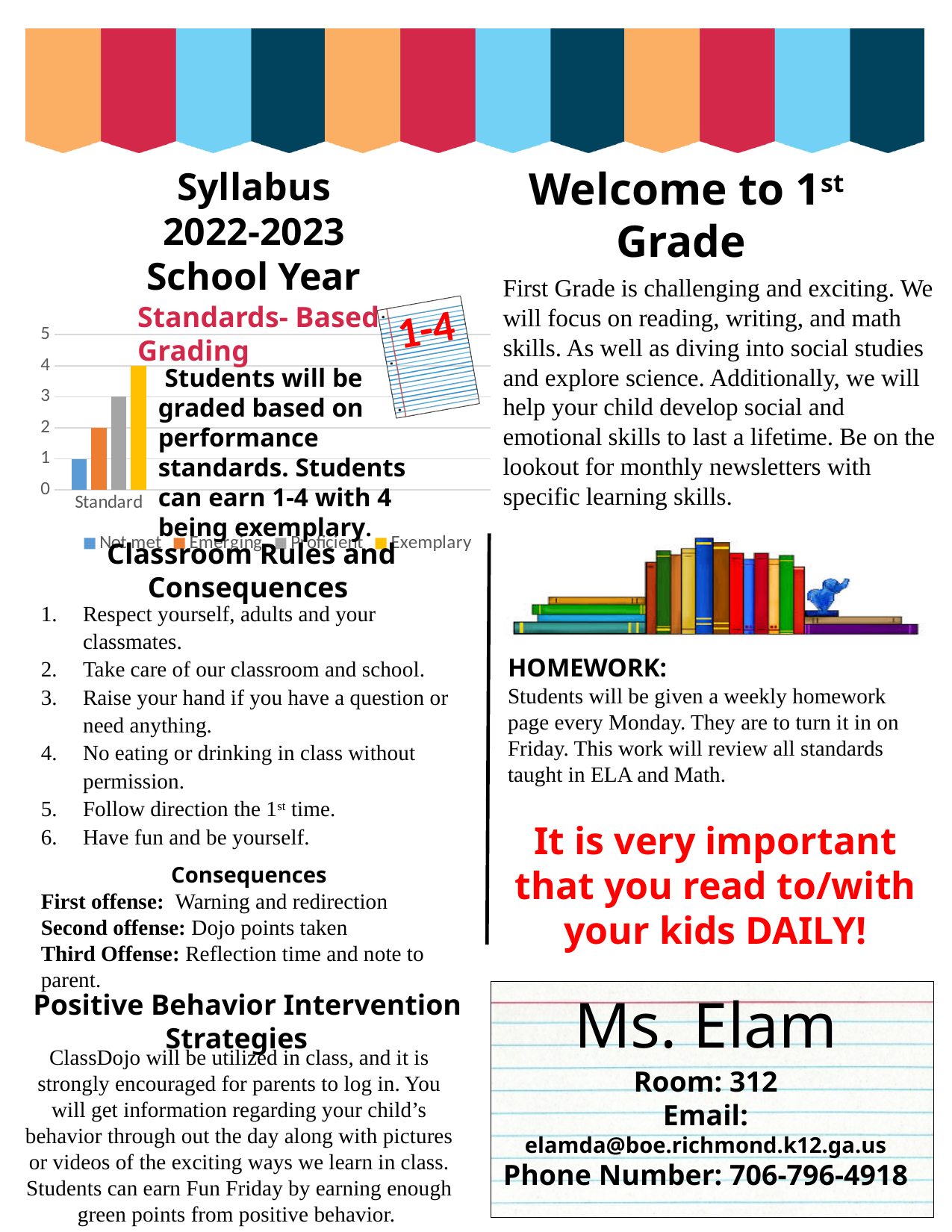
How many categories are shown on the x axis of the chart? 1 How many series does the chart legend list? 4 Which series has the highest bar in the chart? Exemplary What is the value of the Not met bar in the chart? 1 What kind of chart is shown on the slide? bar chart Which is larger in the chart, the Proficient value or the Emerging value? Proficient What is the difference between the Exemplary and Not met values in the chart? 3 What is the value of the Emerging bar in the chart? 2 Which series has the lowest bar in the chart? Not met What is the category label on the x axis of the chart? Standard What is the value of the Proficient bar in the chart? 3 What is the value of the Exemplary bar in the chart? 4